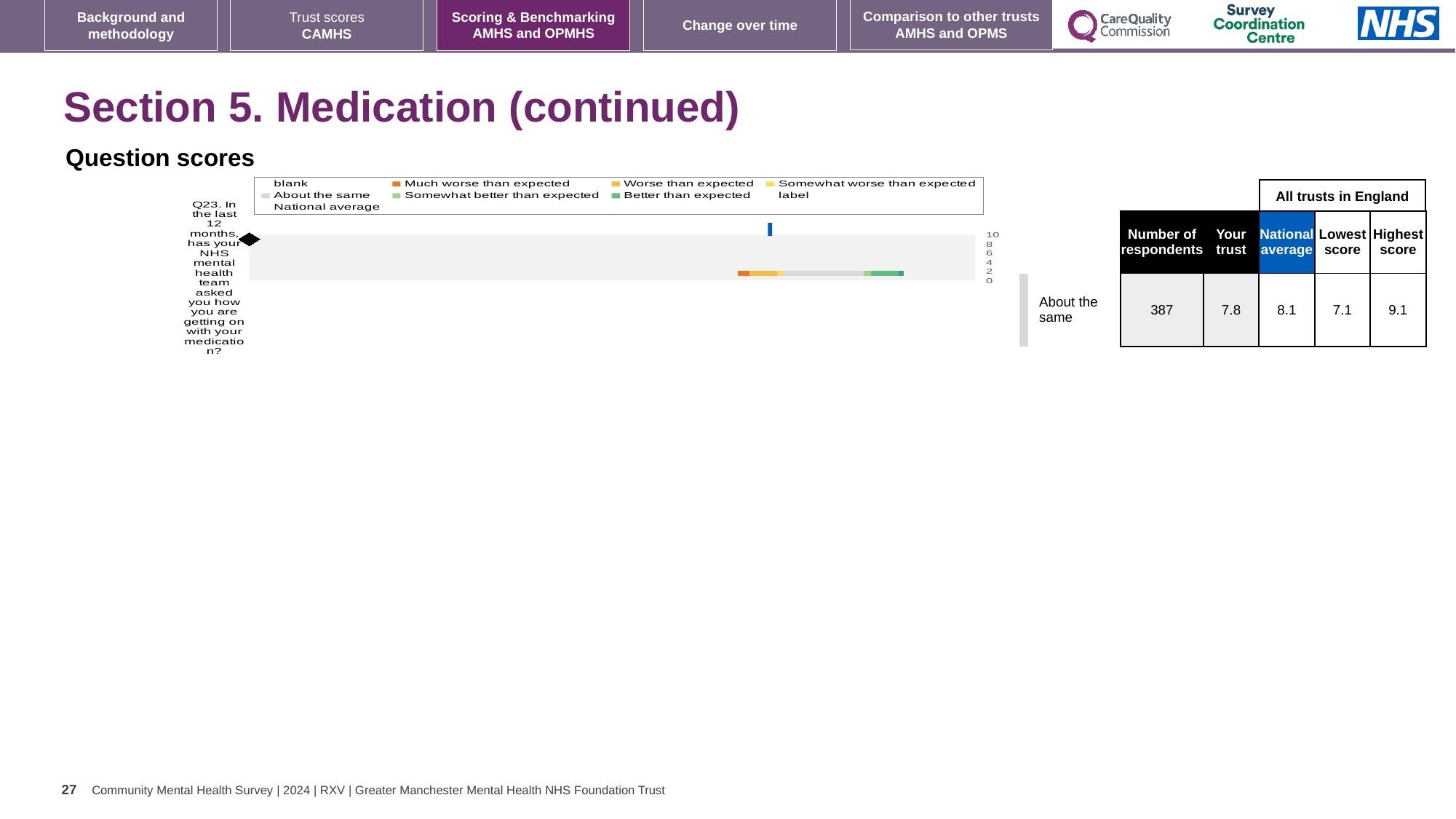
What is the national average score for Q23? 8.1 What is the difference between the highest score and the lowest score for Q23? 2.0 What is the highest score among all trusts in England for Q23? 9.1 How many respondents answered Q23? 387 How many questions (categories) are plotted in the chart? 1 What is the 'Your trust' score for Q23? 7.8 Which is larger for Q23, the 'Your trust' score or the national average? National average What kind of chart is shown under 'Question scores'? bar chart Which benchmark category is Q23 assigned to on the slide? About the same What is the highest value shown on the chart's score axis? 10 By how much does the national average exceed the 'Your trust' score for Q23? 0.3 What is the lowest score among all trusts in England for Q23? 7.1